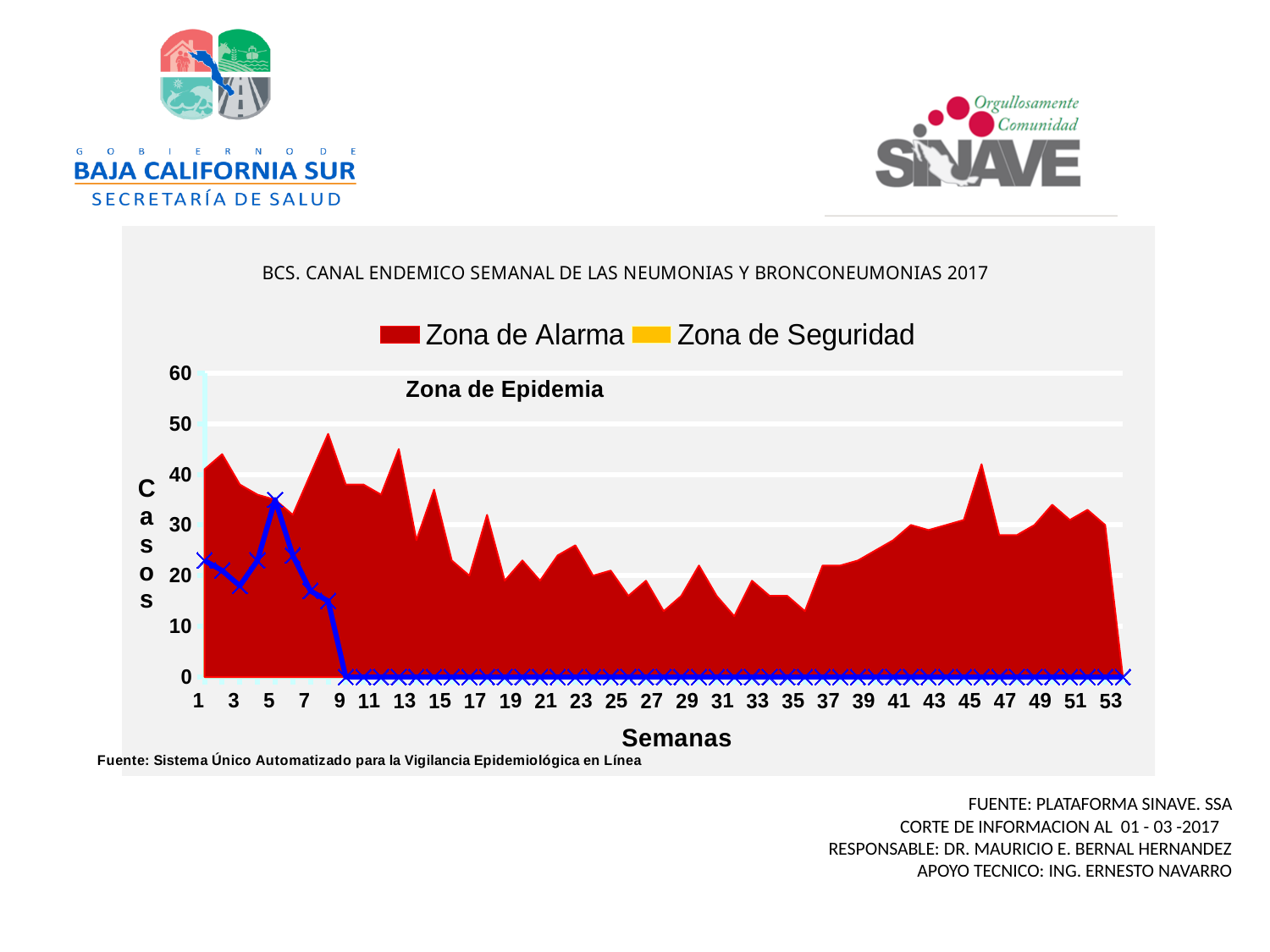
What is the label of the x axis? Semanas Which is larger: the top of the red area at week 46 or at week 37? week 46 What kind of chart is shown on the slide? combination area and line chart How many series does the legend list? 2 What is the title of the chart? BCS. CANAL ENDEMICO SEMANAL DE LAS NEUMONIAS Y BRONCONEUMONIAS 2017 Is the value of the blue line at week 1 greater or less than 30? less Is the value of the blue line at week 20 greater or less than 10? less Does the blue line rise or fall between week 5 and week 9? fall Is the value of the blue line at week 5 greater or less than 30? greater At which week does the blue line reach its highest value? 5